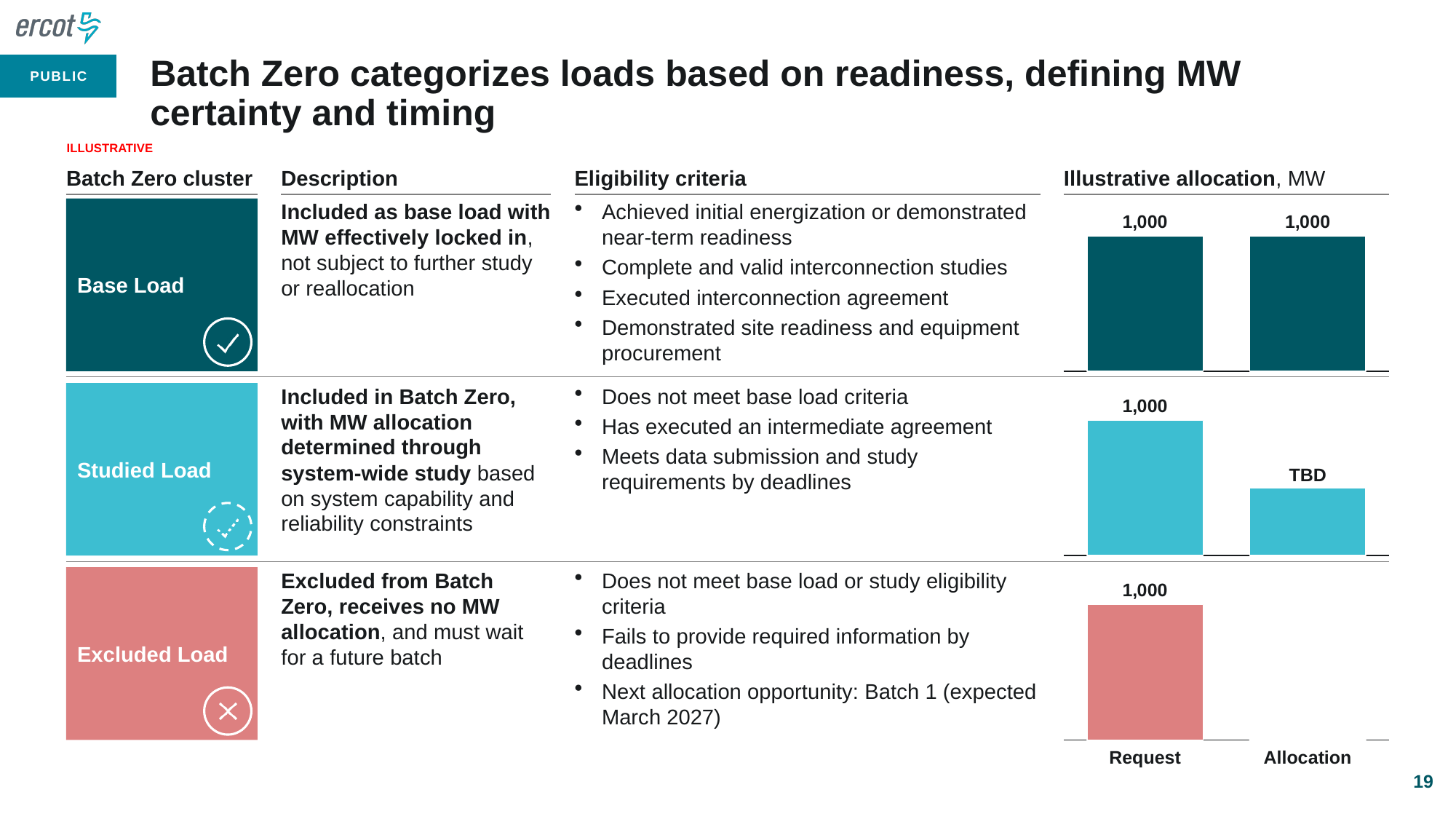
In the Excluded Load row of the Illustrative allocation chart, what is the Request value? 1,000 How many bars are shown in the Base Load row of the Illustrative allocation chart? 2 What unit is stated in the header of the Illustrative allocation column? MW In the Excluded Load row of the Illustrative allocation chart, is there an Allocation bar shown? No What are the two category labels at the bottom of the Illustrative allocation charts? Request and Allocation In the Studied Load row of the Illustrative allocation chart, what is the Request value? 1,000 In the Studied Load row of the Illustrative allocation chart, which bar is taller, Request or Allocation? Request In the Base Load row of the Illustrative allocation chart, what is the Allocation value? 1,000 In the Base Load row of the Illustrative allocation chart, what is the Request value? 1,000 What kind of chart is used in the Illustrative allocation column? Bar chart In the Base Load row of the Illustrative allocation chart, what is the difference between the Request and Allocation values? 0 In the Studied Load row of the Illustrative allocation chart, what label is shown above the Allocation bar? TBD